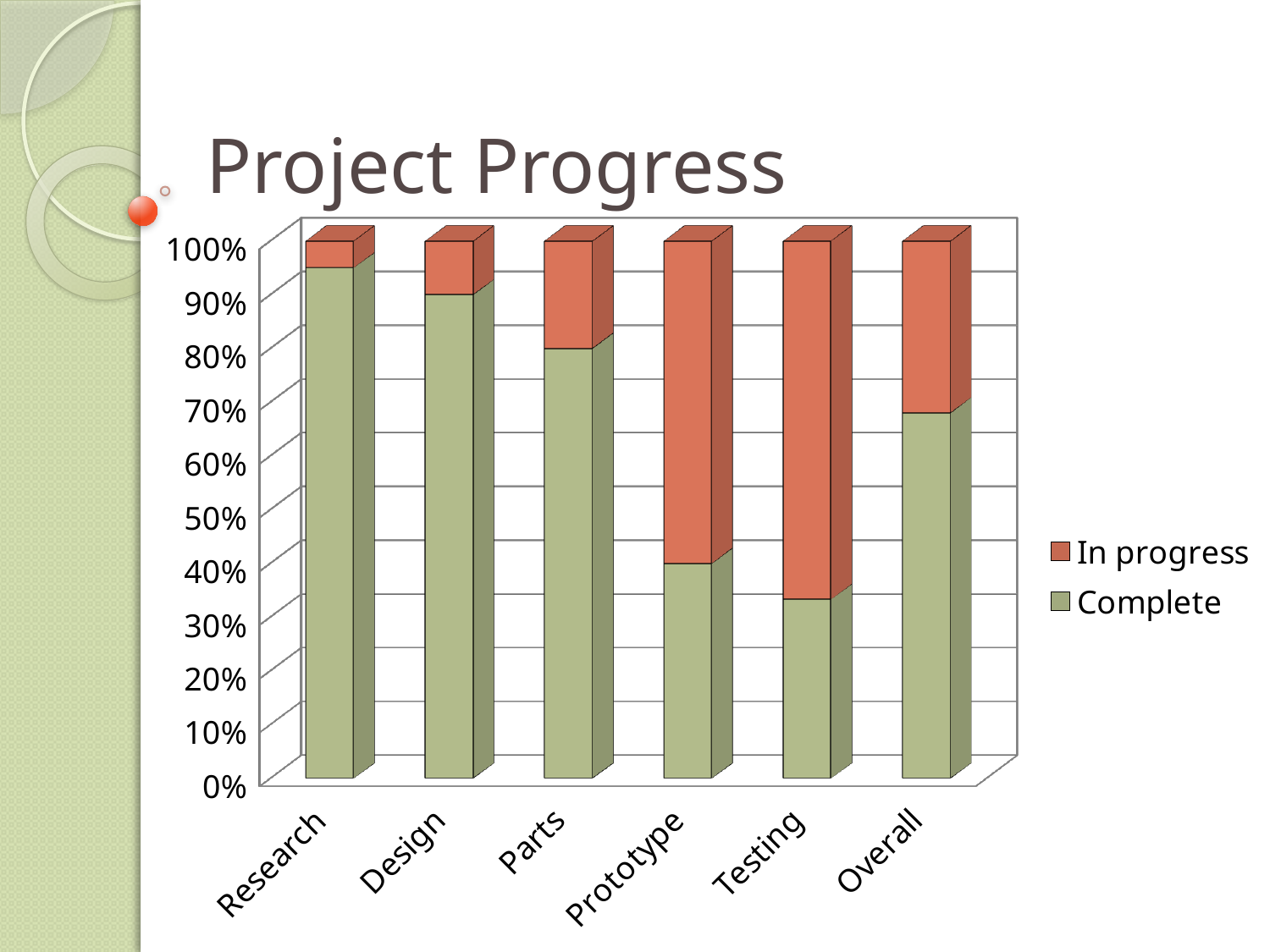
How many categories are shown on the x axis? 6 What kind of chart is shown on the slide? Stacked bar chart Which category has the highest Complete share? Research What is the title of the chart? Project Progress Which has a larger Complete share, Prototype or Testing? Prototype Which colour represents the In progress series in the legend? Red/orange Which category has the lowest Complete share? Testing Is the Complete value for Research greater or less than 90%? greater Is the Complete value for Testing greater or less than 40%? less Which category has the largest In progress share? Testing Is the Complete value for Overall greater or less than 60%? greater How many series does the legend list? 2